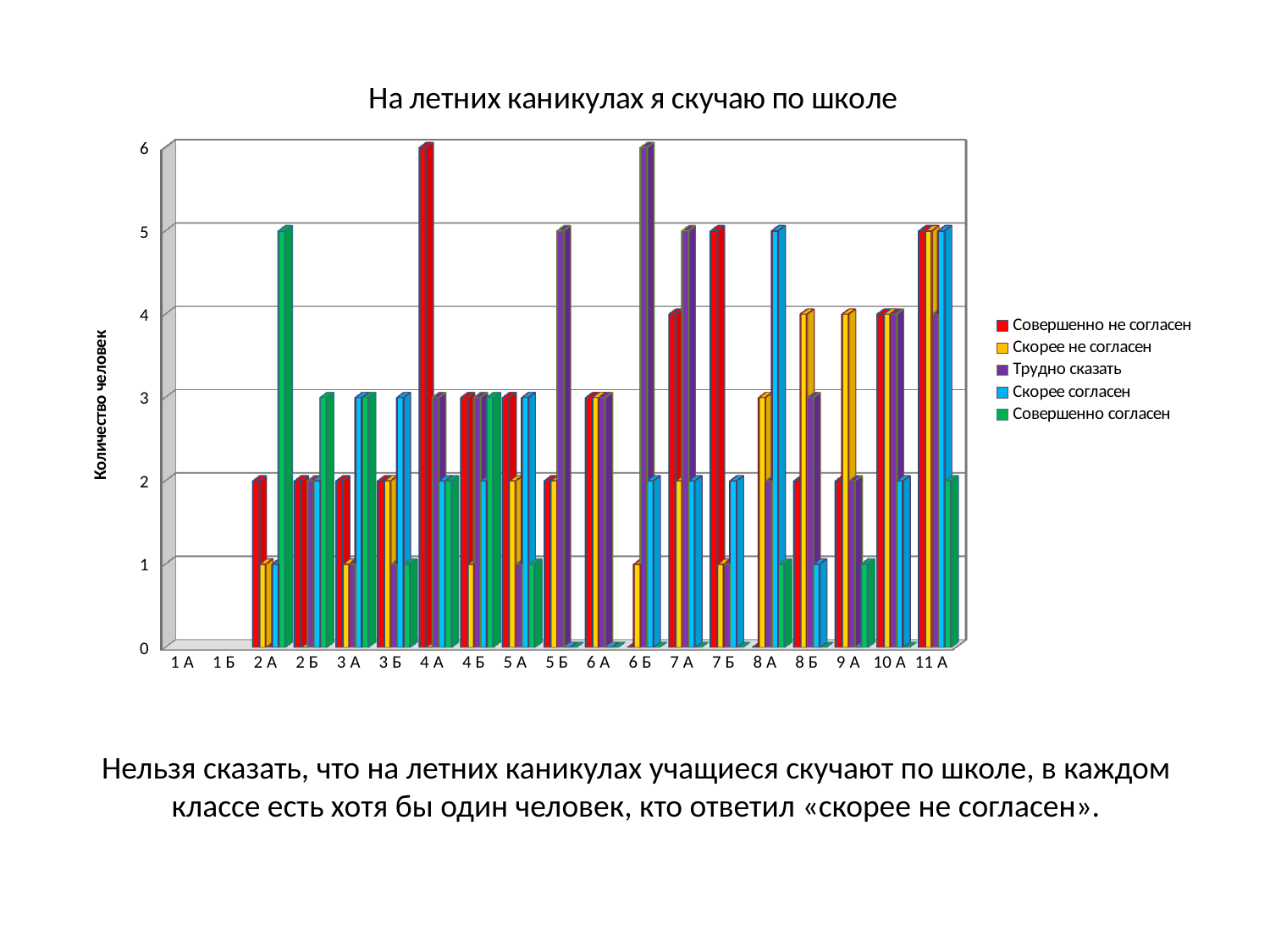
What is the value for 'Совершенно не согласен' in class 4 А? 6 Is the value for 'Совершенно согласен' in class 2 А greater or less than 4? greater How many series does the legend list? 5 What is the title of the chart? На летних каникулах я скучаю по школе Which class has the highest value for the series 'Совершенно не согласен'? 4 А What is the value for 'Совершенно согласен' in class 2 А? 5 What is the label of the vertical axis? Количество человек What type of chart is shown on the slide? bar chart Which is larger: the value for 'Совершенно не согласен' in class 4 А or in class 7 Б? 4 А Which class has the highest value for the series 'Трудно сказать'? 6 Б What is the value for 'Скорее согласен' in class 8 А? 5 How many class categories are shown on the x axis? 19